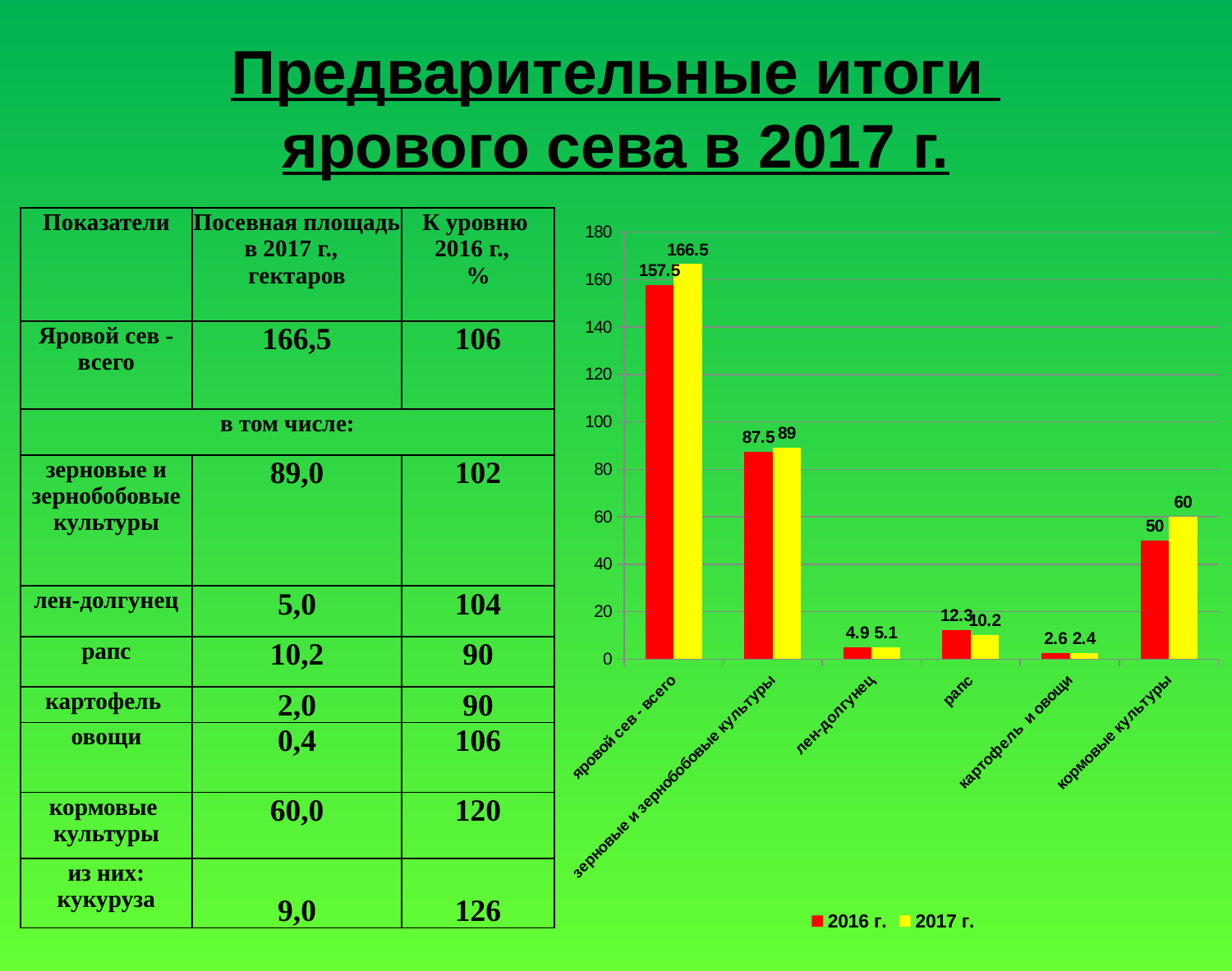
How many series does the chart legend list? 2 What is the value for 'яровой сев - всего' in the 2017 г. series? 166.5 Which category has the lowest value in the 2017 г. series? картофель и овощи How many categories are shown on the x axis of the chart? 6 What is the value for 'кормовые культуры' in the 2017 г. series? 60 What is the value for 'яровой сев - всего' in the 2016 г. series? 157.5 Which colour represents the 2017 г. series in the chart? yellow What is the difference between the 2017 г. and 2016 г. values for 'кормовые культуры'? 10 Which category has the highest value in the 2016 г. series? яровой сев - всего For 'рапс', which series has the larger value, 2016 г. or 2017 г.? 2016 г. What type of chart is shown on the slide? bar chart What is the value for 'рапс' in the 2016 г. series? 12.3